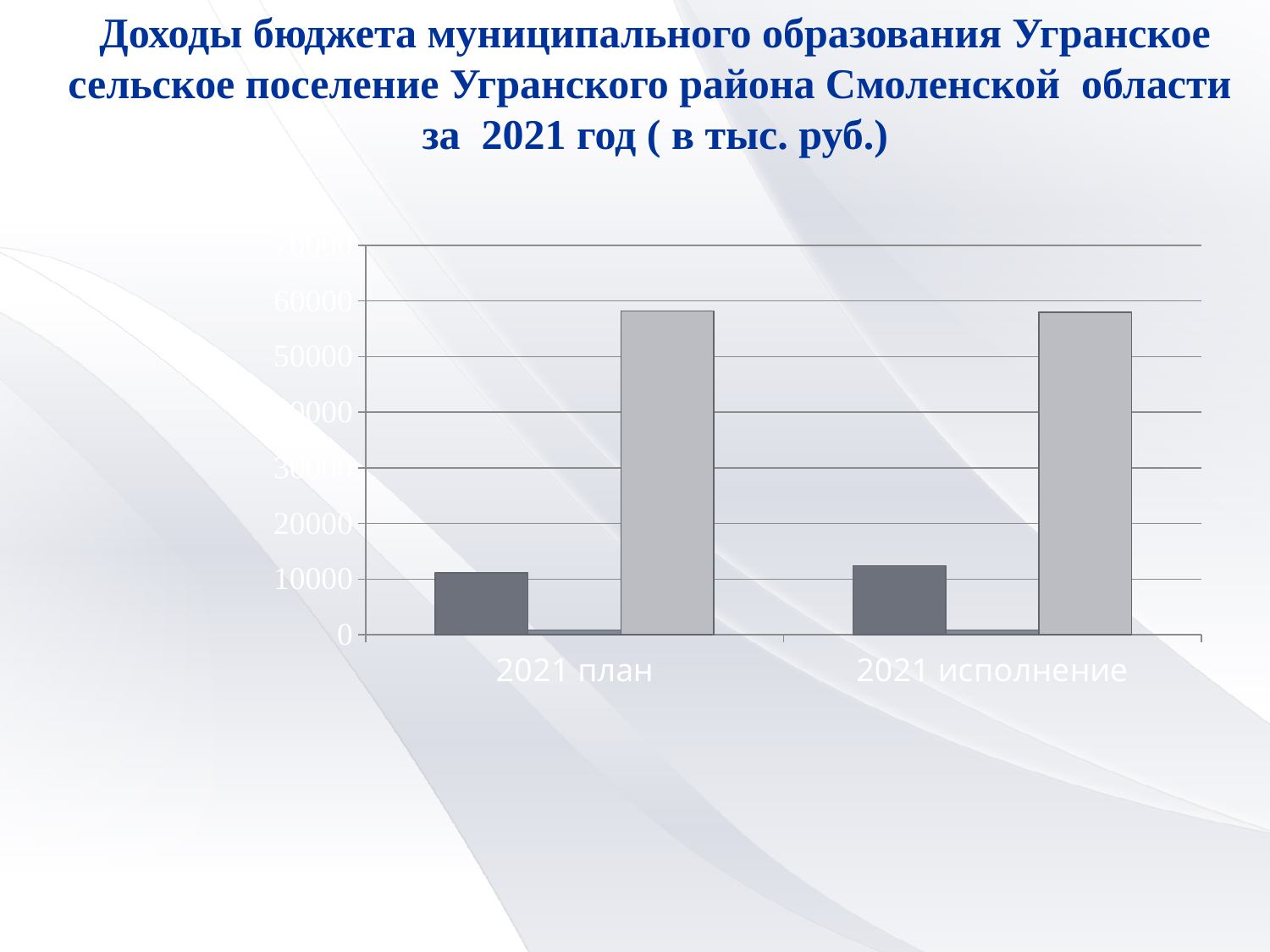
What are the two category labels on the x axis of the chart? 2021 план, 2021 исполнение Is the value of the dark gray bar for "2021 исполнение" greater or less than 10000? greater What kind of chart is shown on the slide? bar chart Is the value of the tallest (light gray) bar for "2021 исполнение" greater or less than 60000? less How many bars are plotted for the category "2021 план"? 3 For "2021 исполнение", which is larger: the dark gray bar or the light gray bar? the light gray bar For "2021 план", which is larger: the dark gray bar or the light gray bar? the light gray bar Is the value of the dark gray bar for "2021 план" greater or less than 20000? less What is the highest value shown on the y axis of the chart? 70000 Which bar is the lowest within the "2021 план" category? the middle bar How many categories are shown on the x axis of the chart? 2